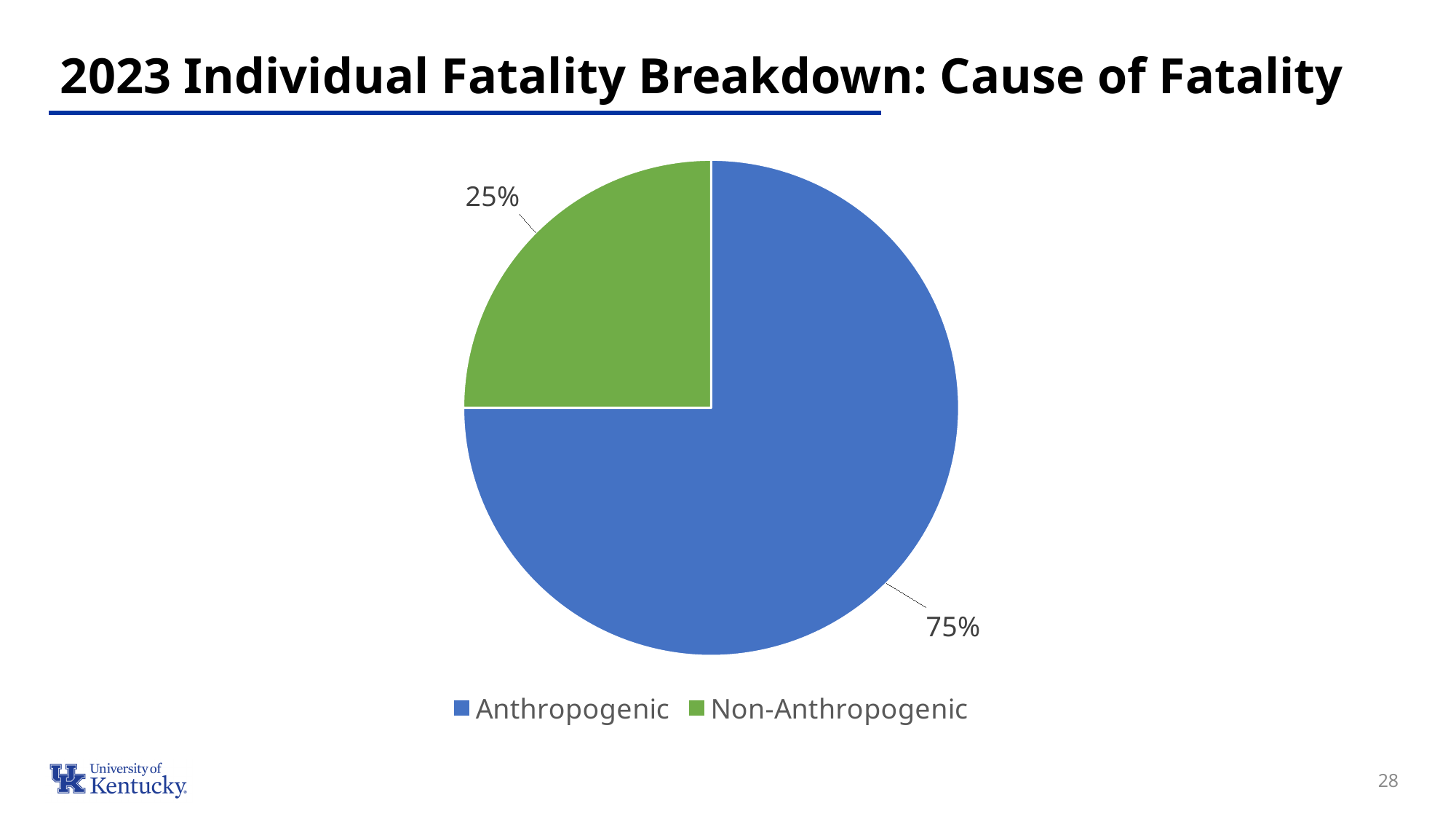
Which category has the largest share of the pie? Anthropogenic What colour represents Non-Anthropogenic in the pie chart? green Which is larger, the Anthropogenic share or the Non-Anthropogenic share? Anthropogenic How many categories does the pie chart show? 2 What share of the pie is Anthropogenic? 75% What is the title of the slide containing the chart? 2023 Individual Fatality Breakdown: Cause of Fatality Which category has the smallest share of the pie? Non-Anthropogenic What is the difference in percentage points between the Anthropogenic and Non-Anthropogenic shares? 50 What kind of chart is shown on the slide? pie chart What share of the pie is Non-Anthropogenic? 25% How many entries does the legend list? 2